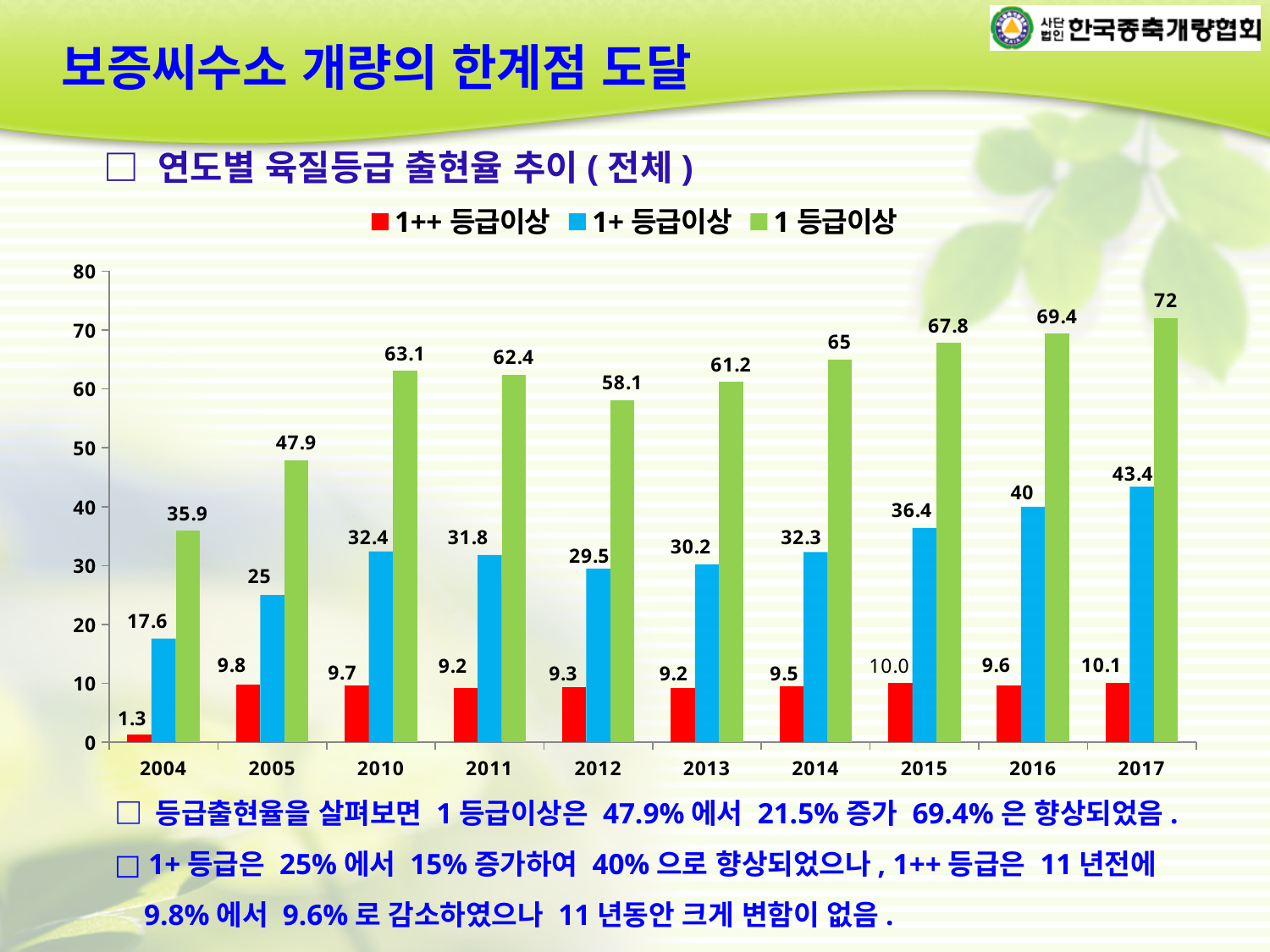
What is the value for 1++ 등급이상 in 2004? 1.3 What is the value for 1+ 등급이상 in 2010? 32.4 What kind of chart is shown on the slide? bar chart How many series does the legend list? 3 Which colour represents the 1++ 등급이상 series? red In which year is the 1+ 등급이상 value the highest? 2017 What is the value for 1 등급이상 in 2017? 72 Does the 1 등급이상 value rise or fall from 2012 to 2017? rise How many years are shown on the x axis? 10 What is the difference between the 1 등급이상 values in 2017 and 2016? 2.6 In which year is the 1 등급이상 value the lowest? 2004 Which is larger, the 1+ 등급이상 value in 2012 or in 2013? 2013